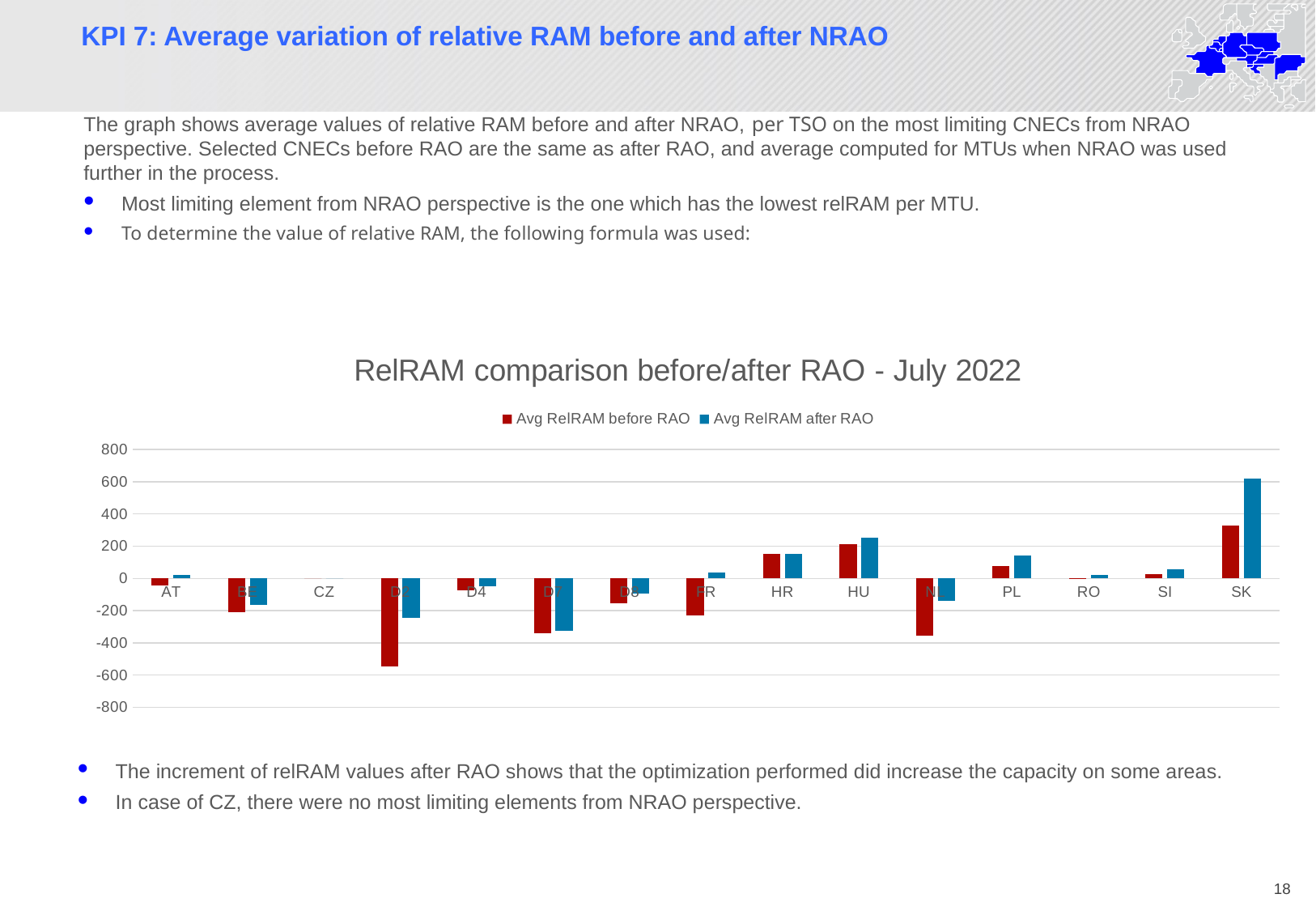
Is the Avg RelRAM after RAO for SK greater or less than 400? greater For SK, which is larger: Avg RelRAM before RAO or Avg RelRAM after RAO? Avg RelRAM after RAO Which category has the highest Avg RelRAM after RAO? SK Which category has the highest Avg RelRAM before RAO? SK Which is larger: the Avg RelRAM after RAO for HU or for HR? HU How many series does the chart's legend list? 2 What type of chart is shown on the slide? Bar chart Which colour represents the Avg RelRAM after RAO series in the chart? Blue Is the Avg RelRAM before RAO for HR greater or less than 200? less How many categories (TSOs) are shown on the x axis of the chart? 15 What is the title of the chart? RelRAM comparison before/after RAO - July 2022 Is the Avg RelRAM before RAO for SK greater or less than 200? greater